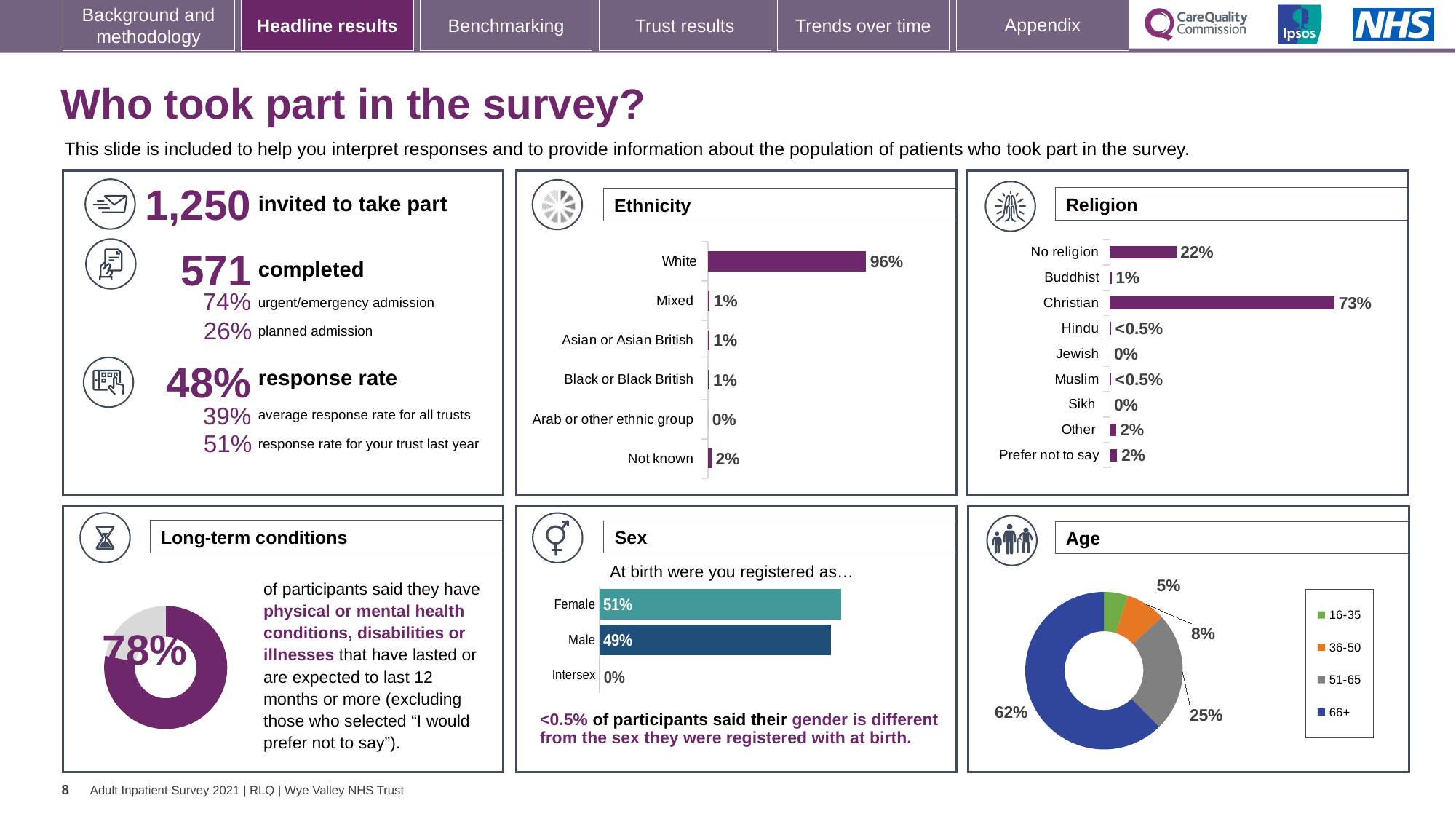
In the Ethnicity chart, how many categories are shown? 6 In the Religion chart, what is the value for Christian? 73% In the Religion chart, what is the difference between Christian and No religion? 51% In the Sex chart, what is the value for Female? 51% In the Religion chart, how many categories are shown? 9 In the Ethnicity chart, what is the value for White? 96% In the Religion chart, what is the value for No religion? 22% What kind of chart is the Age chart? Doughnut chart In the Age chart, how many age groups does the legend list? 4 In the Sex chart, which is larger, Female or Male? Female In the Age chart, what share of participants are aged 66+? 62% In the Ethnicity chart, which category has the highest value? White